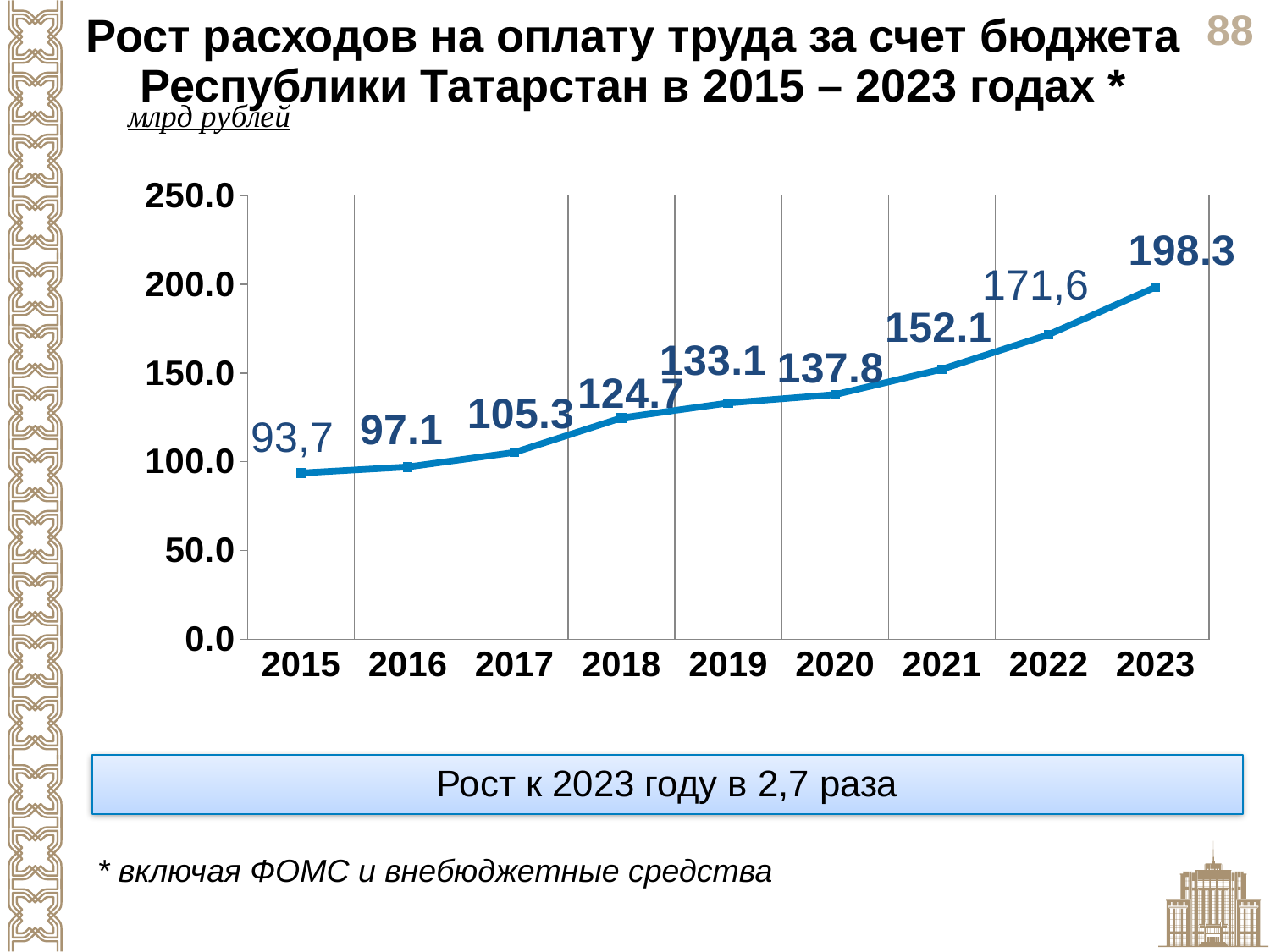
What is the value for 2019? 133.1 What is the value for 2023? 198.3 Which year has the lowest value? 2015 Do the values rise or fall from 2015 to 2023? rise What is the difference between the values for 2021 and 2020? 14.3 Which is larger, the value for 2020 or the value for 2019? 2020 What is the difference between the values for 2018 and 2017? 19.4 What kind of chart is shown on the slide? line chart Which year has the highest value? 2023 What is the value for 2022? 171,6 What is the value for 2015? 93,7 How many years are plotted on the x axis? 9